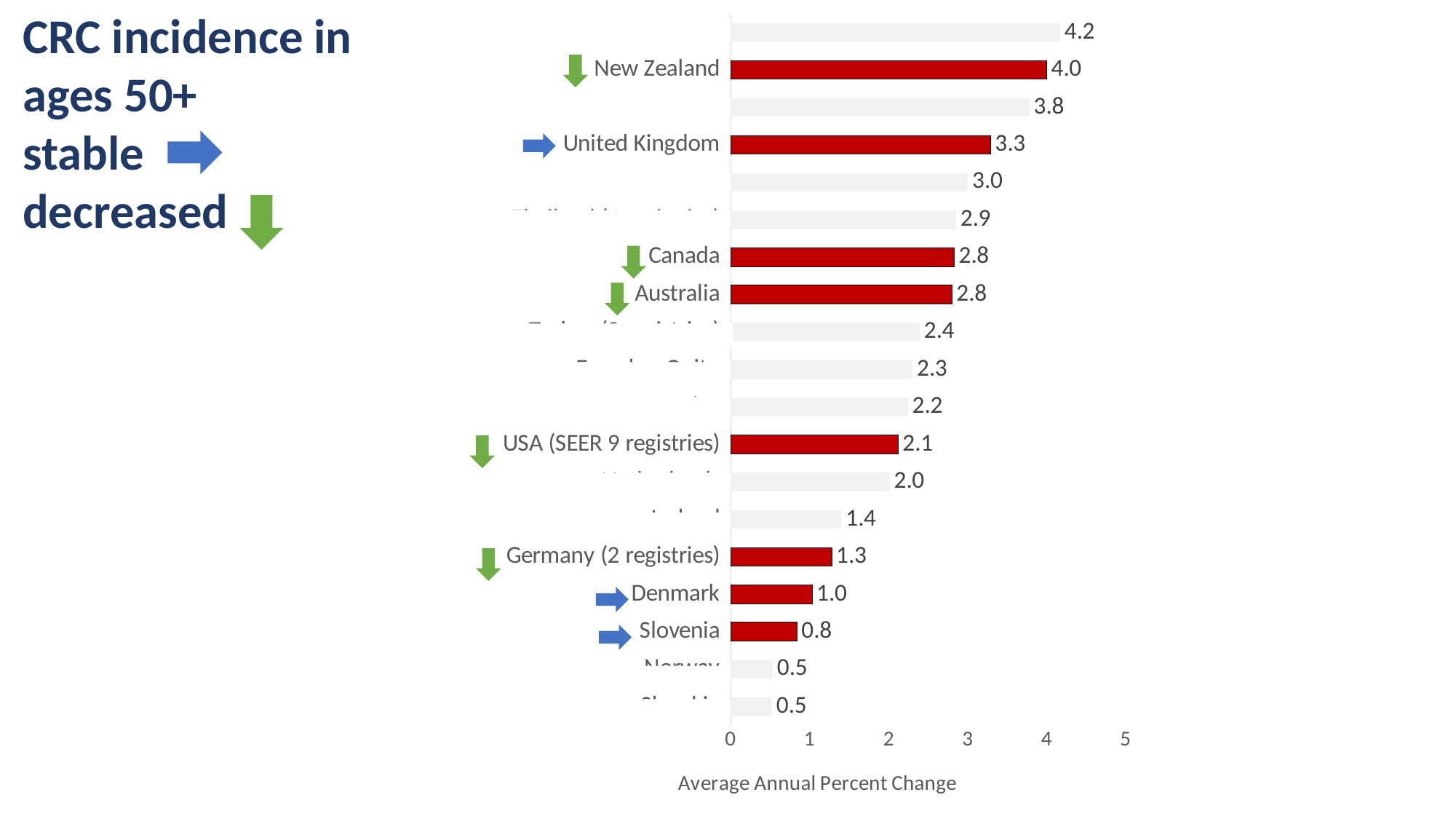
What is the value for New Zealand? 4.0 What is the value for USA (SEER 9 registries)? 2.1 What is the value for Germany (2 registries)? 1.3 What kind of chart is shown on the slide? bar chart Which is larger, the value for Canada or the value for USA (SEER 9 registries)? Canada What is the value for Slovenia? 0.8 What is the difference between the values for New Zealand and United Kingdom? 0.7 What is the value for Canada? 2.8 How many bars are plotted in the chart? 19 What is the value for United Kingdom? 3.3 Is the value for Denmark greater or less than 2? less What is the title of the horizontal axis? Average Annual Percent Change